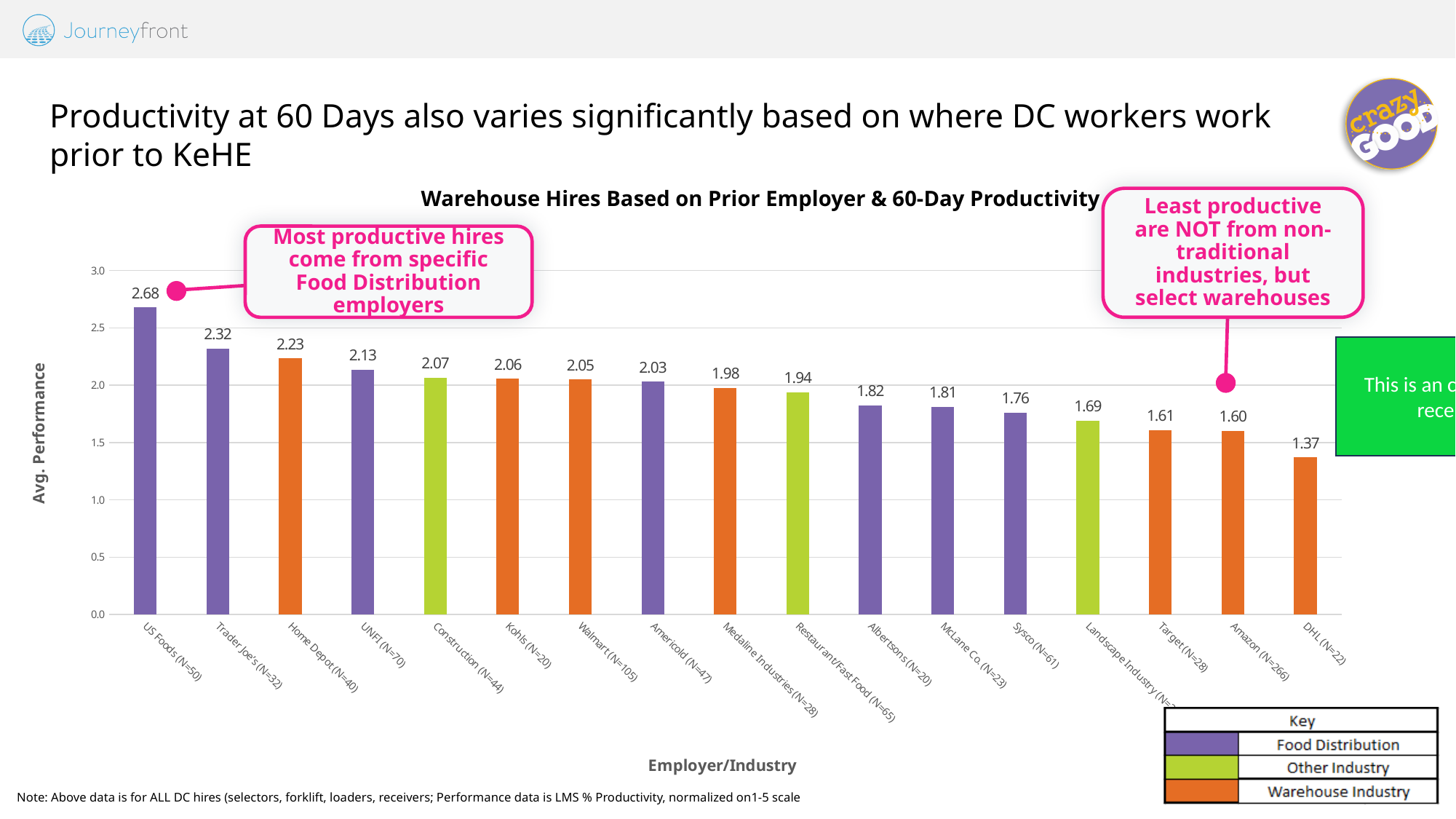
Which employer/industry has the lowest average performance? DHL (N=22) What is the average performance value for Walmart (N=105)? 2.05 What is the difference between the average performance of US Foods (N=50) and DHL (N=22)? 1.31 How many categories does the key list? 3 What is the average performance value for Amazon (N=266)? 1.60 What kind of chart is shown on the slide? Bar chart Is the value for Target (N=28) greater or less than 2.0? less How many employer/industry categories are shown on the chart? 17 What is the difference between the average performance of Trader Joe's (N=32) and Home Depot (N=40)? 0.09 Which employer/industry has the highest average performance? US Foods (N=50) Which has a higher average performance, Sysco (N=61) or Construction (N=44)? Construction (N=44) What is the average performance value for US Foods (N=50)? 2.68